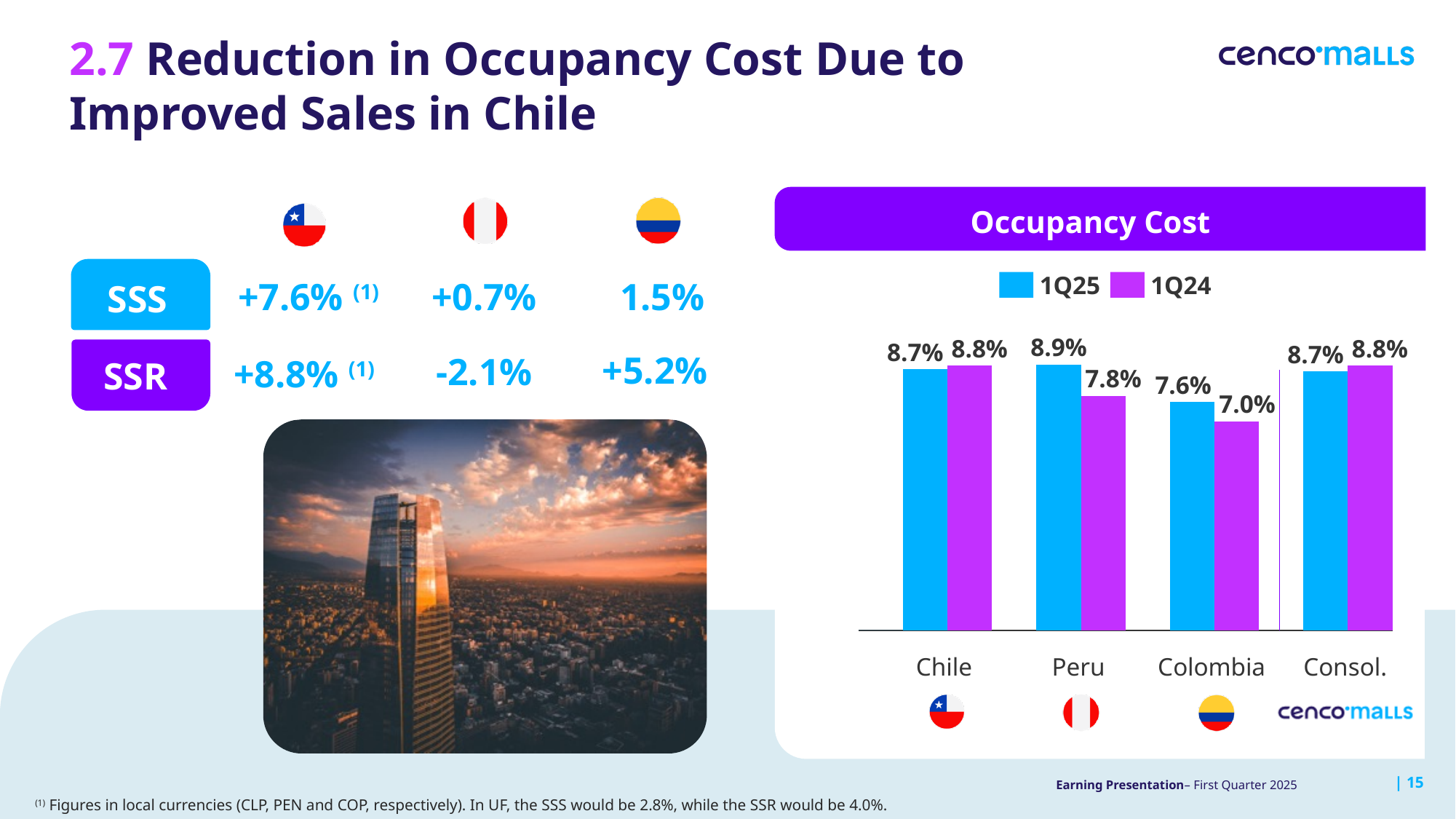
Is Colombia's Occupancy Cost higher in 1Q25 or 1Q24? 1Q25 What is the consolidated (Consol.) Occupancy Cost in 1Q24? 8.8% What is the Occupancy Cost for Peru in 1Q24? 7.8% What is the Occupancy Cost for Colombia in 1Q25? 7.6% What is the Occupancy Cost for Chile in 1Q25? 8.7% How many categories are shown on the x axis of the Occupancy Cost chart? 4 What is the difference between Peru's Occupancy Cost in 1Q25 and 1Q24? 1.1% How many series does the legend of the Occupancy Cost chart list? 2 What type of chart is the Occupancy Cost chart? Bar chart Which category has the highest Occupancy Cost in 1Q25? Peru Which category has the lowest Occupancy Cost in 1Q24? Colombia Which colour represents the 1Q24 series in the Occupancy Cost chart? Purple